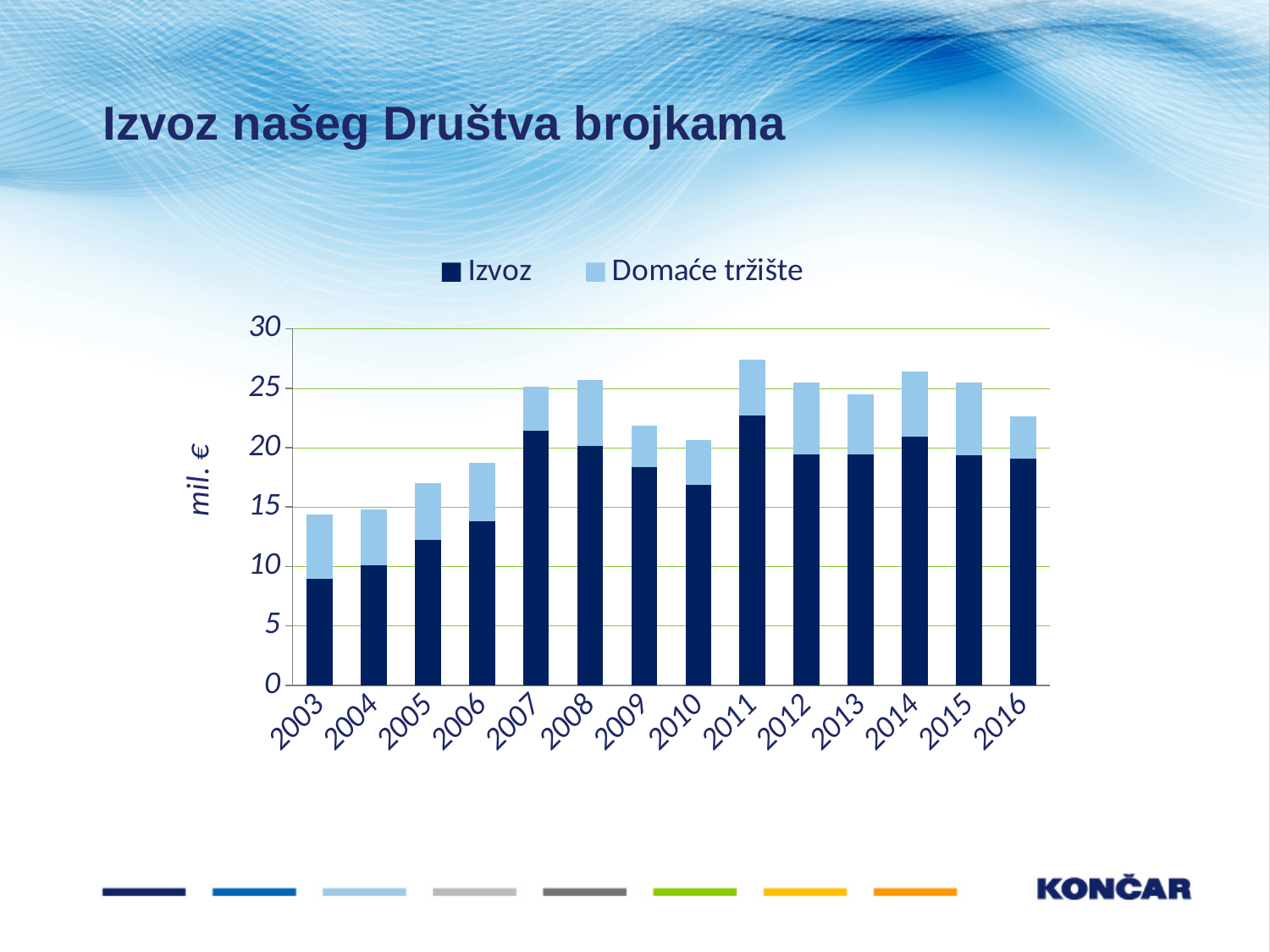
How many series does the chart legend list? 2 Which year has the highest Izvoz value? 2011 What unit is shown on the y axis label of the chart? mil. € Is the Izvoz value for 2011 greater or less than 20? greater Is the Izvoz value for 2016 greater or less than 20? less Which year has the lowest Izvoz value? 2003 How many years are shown on the x axis of the chart? 14 What kind of chart is shown on the slide? stacked bar chart Is the Izvoz value for 2003 greater or less than 10? less Which year has the larger Izvoz value, 2007 or 2010? 2007 Does the Izvoz value rise or fall from 2003 to 2007? rise